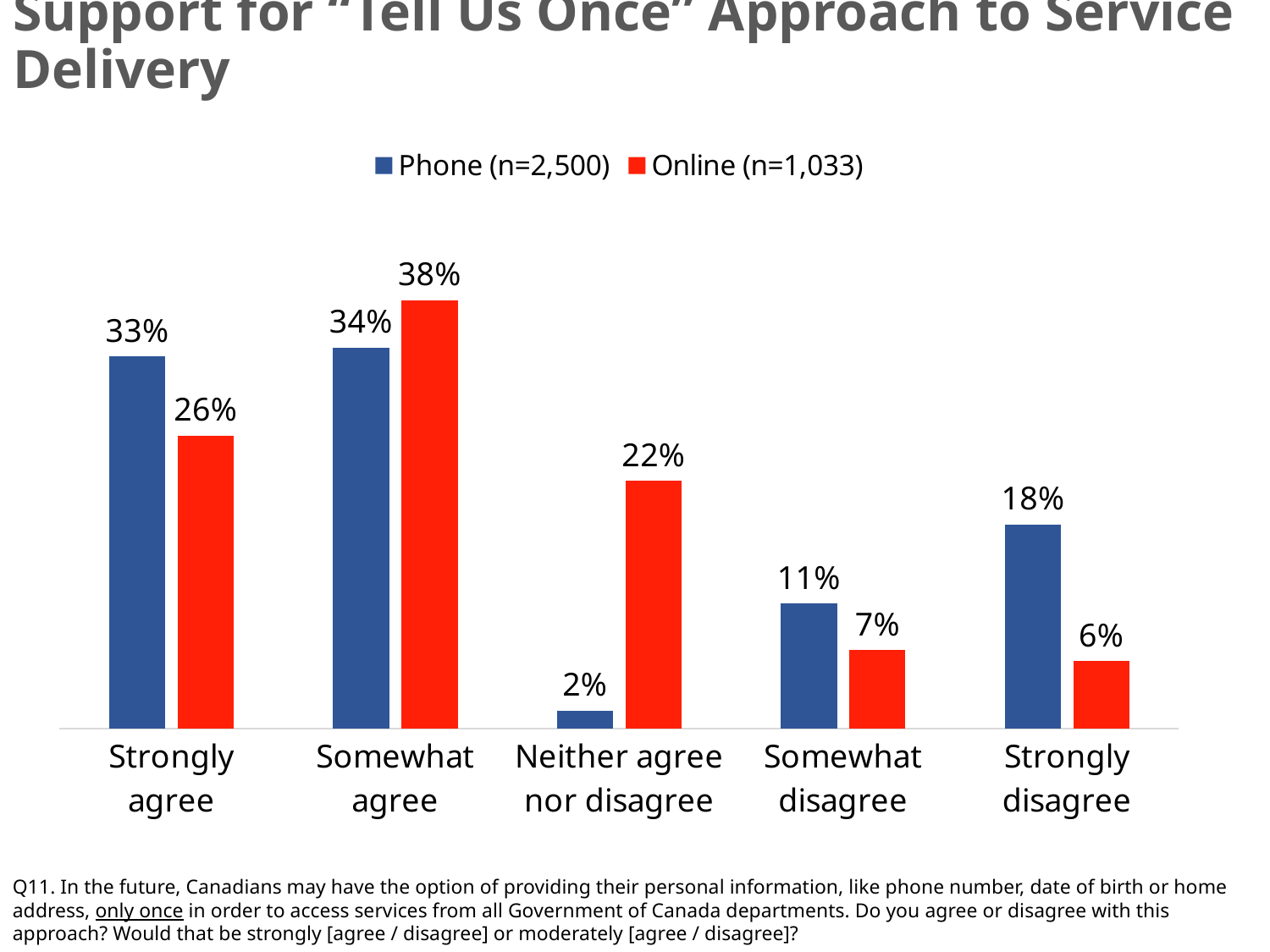
Which category has the highest value for the Online series? Somewhat agree Which is larger for Strongly agree: the Phone value or the Online value? Phone What percentage of Online respondents neither agree nor disagree? 22% What is the difference between the Online and Phone values for Neither agree nor disagree? 20% What percentage of Phone respondents strongly agree? 33% How many response categories are shown on the x axis? 5 What is the sample size for the Online series shown in the legend? n=1,033 What percentage of Online respondents strongly disagree? 6% What is the difference between the Phone and Online values for Strongly disagree? 12% How many series does the legend list? 2 Which category has the lowest value for the Phone series? Neither agree nor disagree What kind of chart is shown on the slide? Bar chart